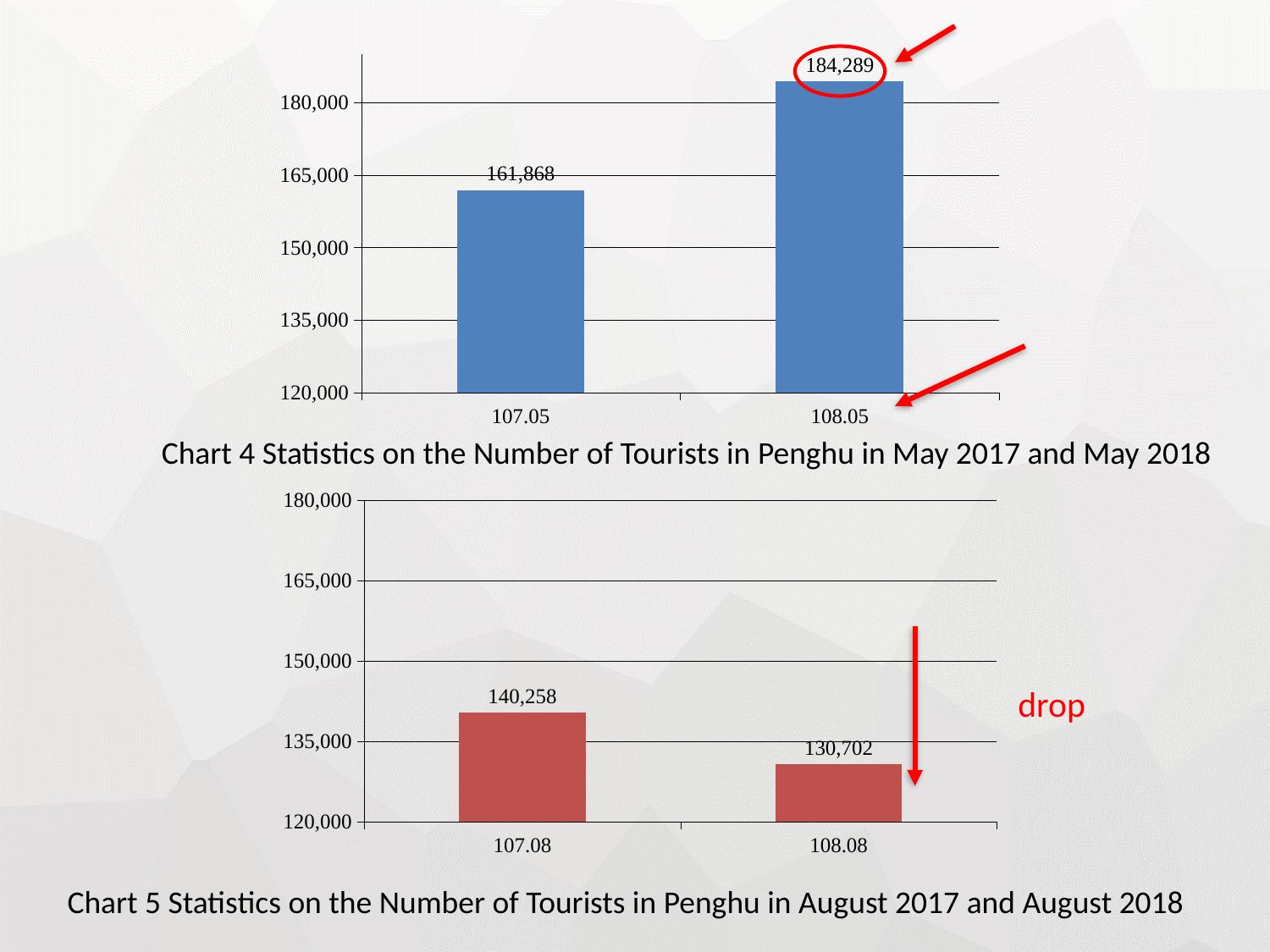
What is the title of the top chart? Chart 4 Statistics on the Number of Tourists in Penghu in May 2017 and May 2018 In Chart 4 (top chart), how many bars are plotted? 2 In Chart 5 (bottom chart), do the values rise or fall from 107.08 to 108.08? fall What kind of chart is Chart 5 (bottom chart)? bar chart In Chart 4 (top chart), what is the difference between the values for 108.05 and 107.05? 22,421 In Chart 4 (top chart), what is the value for 107.05? 161,868 In Chart 4 (top chart), which category has the higher value? 108.05 In Chart 4 (top chart), what is the value for 108.05? 184,289 In Chart 5 (bottom chart), which category has the lower value? 108.08 In Chart 5 (bottom chart), what is the value for 108.08? 130,702 In Chart 5 (bottom chart), what is the value for 107.08? 140,258 In Chart 5 (bottom chart), what is the difference between the values for 107.08 and 108.08? 9,556